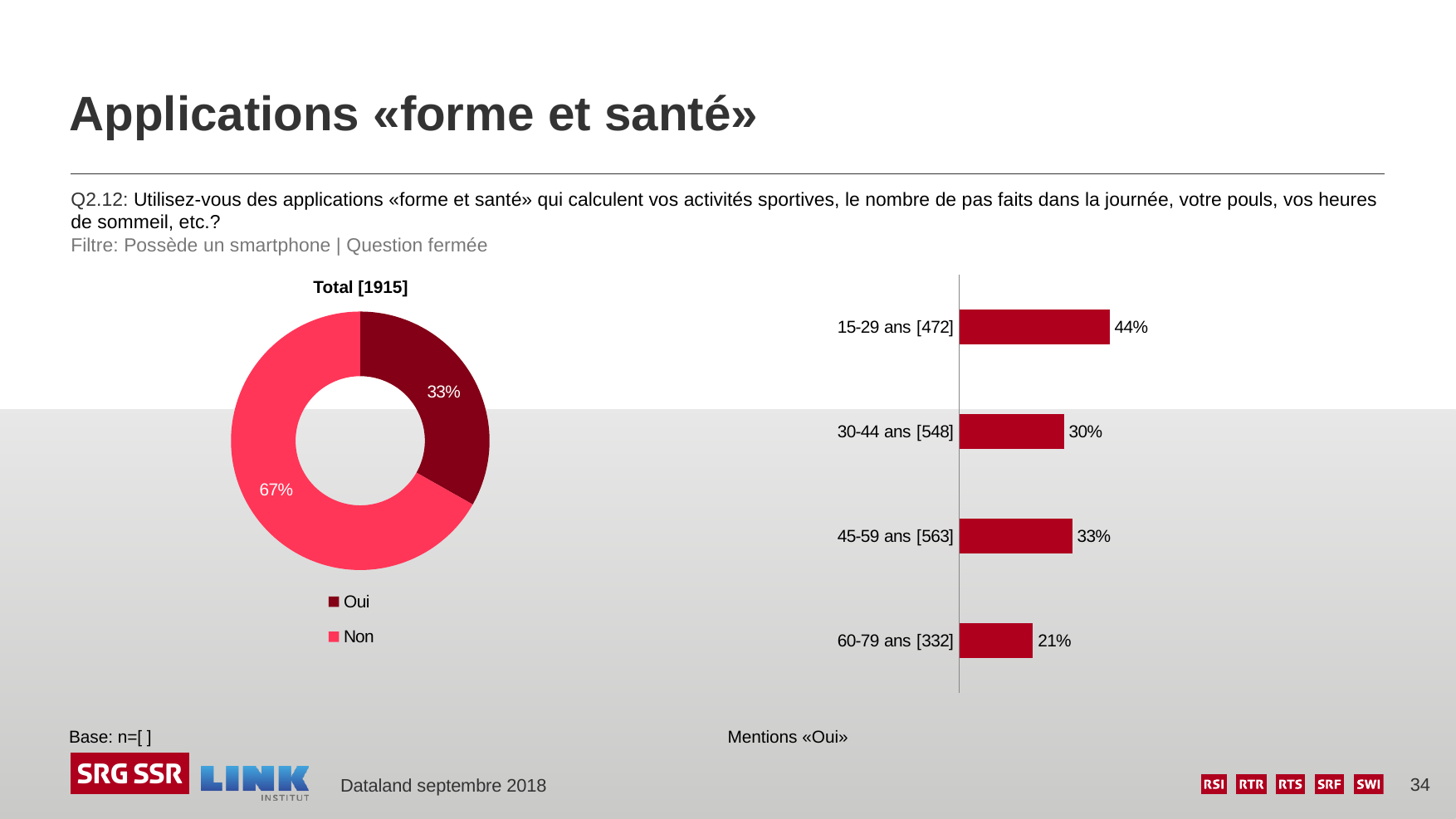
In the donut chart titled 'Total [1915]', what share of respondents answered 'Oui'? 33% What kind of chart is the chart on the right of the slide? Bar chart In the bar chart on the right, which is larger: the value for '30-44 ans [548]' or '45-59 ans [563]'? 45-59 ans [563] In the donut chart titled 'Total [1915]', what share of respondents answered 'Non'? 67% In the donut chart titled 'Total [1915]', how many entries does the legend list? 2 In the bar chart on the right, what is the difference between the values for '15-29 ans [472]' and '60-79 ans [332]'? 23 percentage points What kind of chart is the chart on the left of the slide? Donut (pie) chart In the bar chart on the right, how many age groups are shown? 4 In the bar chart on the right, which age group has the highest value? 15-29 ans [472] In the bar chart on the right, what is the value for '15-29 ans [472]'? 44% In the bar chart on the right, what is the value for '60-79 ans [332]'? 21% In the bar chart on the right, which age group has the lowest value? 60-79 ans [332]